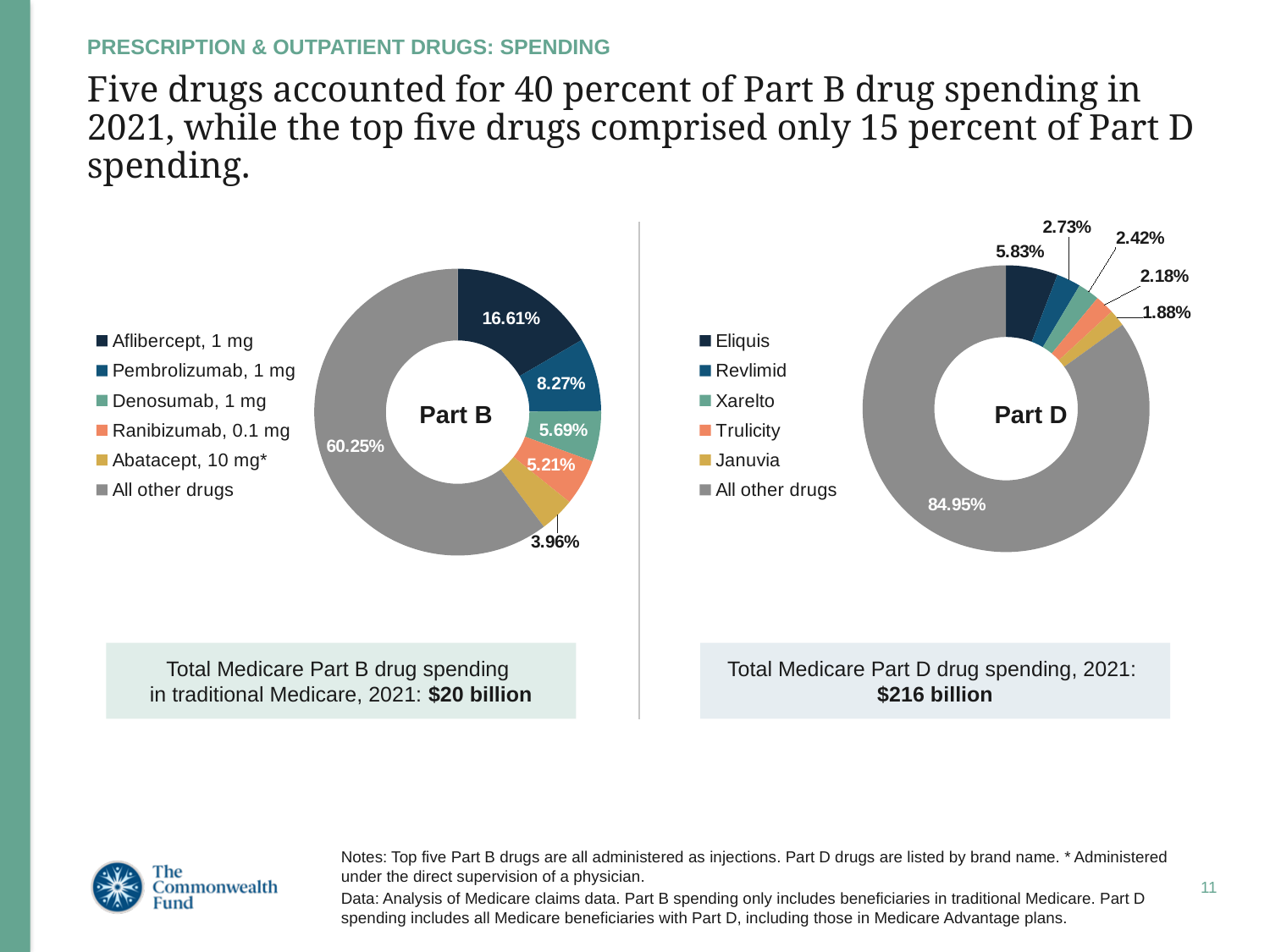
In the Part B chart, which of the five named drugs has the smallest share? Abatacept, 10 mg* In the Part D chart, what is the difference in percentage points between Eliquis and Revlimid? 3.10% In the Part D chart, what share of spending is attributed to All other drugs? 84.95% In the Part B chart, what share of spending is attributed to Pembrolizumab, 1 mg? 8.27% In the Part D chart, which of the five named drugs has the largest share? Eliquis How many slices does the Part D chart have? 6 In the Part B chart, what share of spending is attributed to Aflibercept, 1 mg? 16.61% Which is larger: the share for Denosumab, 1 mg in the Part B chart or the share for Eliquis in the Part D chart? Eliquis in the Part D chart In the Part D chart, what share of spending is attributed to Eliquis? 5.83% What kind of chart is used for Part B? Pie (donut) chart In the Part D chart, what share of spending is attributed to Januvia? 1.88% In the Part B chart, what is the difference in percentage points between Aflibercept, 1 mg and Pembrolizumab, 1 mg? 8.34%